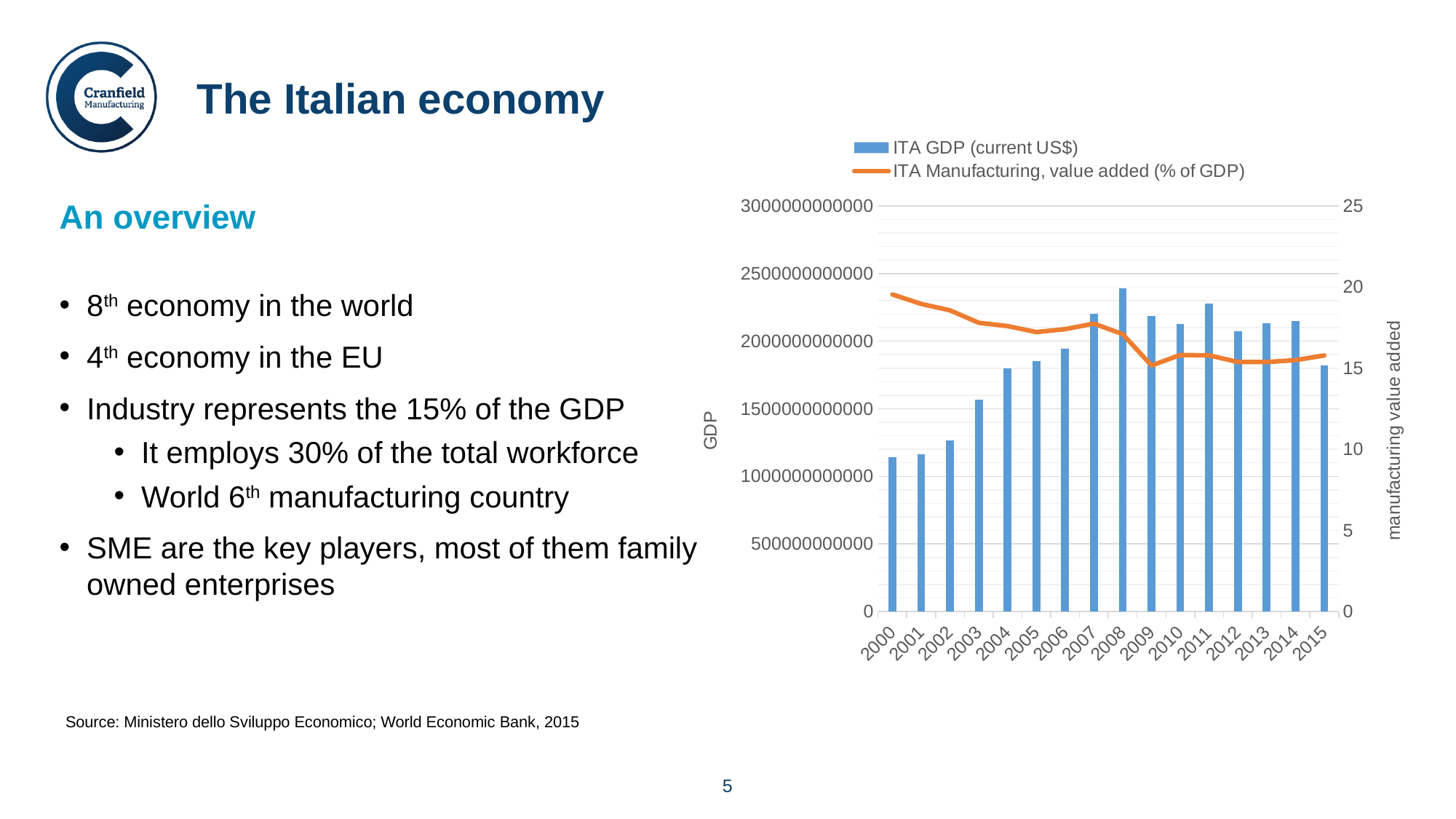
How many series does the chart legend list? 2 Is the ITA GDP (current US$) value for 2008 greater or less than 2000000000000? greater Does the ITA GDP (current US$) series rise or fall from 2000 to 2008? rise In which year is the ITA GDP (current US$) bar the highest? 2008 Does the ITA Manufacturing, value added (% of GDP) line generally rise or fall from 2000 to 2015? fall How many years are shown on the x axis of the chart? 16 What kind of chart is used to show the ITA GDP (current US$) series? bar chart In which year is the ITA Manufacturing, value added (% of GDP) line at its highest? 2000 Is the ITA Manufacturing, value added (% of GDP) value for 2000 greater or less than 20? less Is the ITA GDP (current US$) value for 2015 greater or less than 2000000000000? less What is the title of the right-hand vertical axis of the chart? manufacturing value added Which year has the larger ITA GDP (current US$) bar, 2004 or 2007? 2007